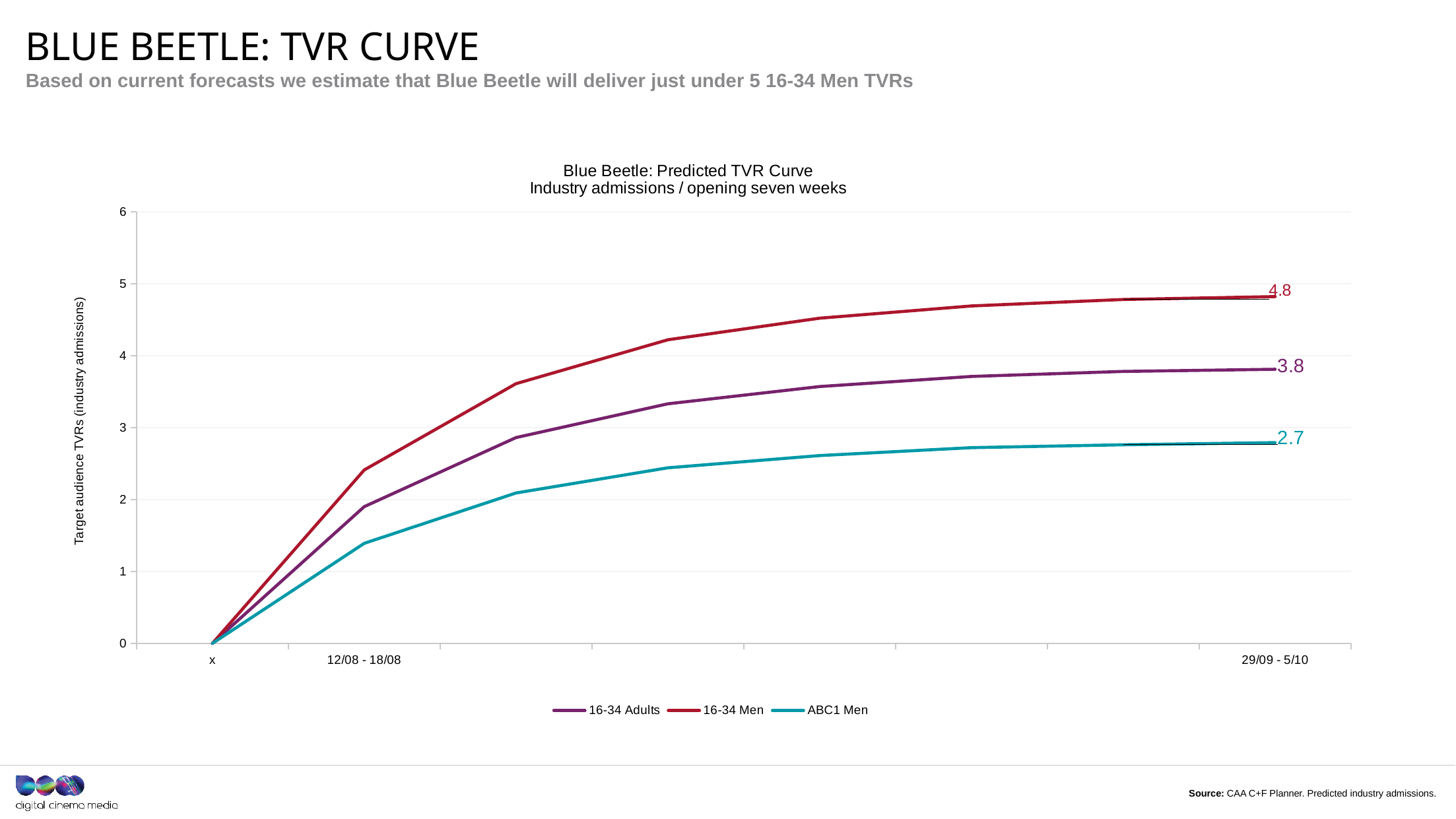
What kind of chart is shown on the slide? Line chart What is the difference between the final values of 16-34 Men and 16-34 Adults? 1.0 Do the TVR values rise or fall along the x axis? Rise What is the final value shown for the 16-34 Adults series? 3.8 Is the value for ABC1 Men at 12/08 - 18/08 greater or less than 2? less What is the difference between the final values of 16-34 Men and ABC1 Men? 2.0 What is the final value shown for the ABC1 Men series? 2.7 Which series reaches the highest TVR value at the end of the curve? 16-34 Men Which series has the lowest TVR value at the end of the curve? ABC1 Men Which series ends higher, 16-34 Adults or ABC1 Men? 16-34 Adults What is the final value shown for the 16-34 Men series? 4.8 How many series does the legend list? 3